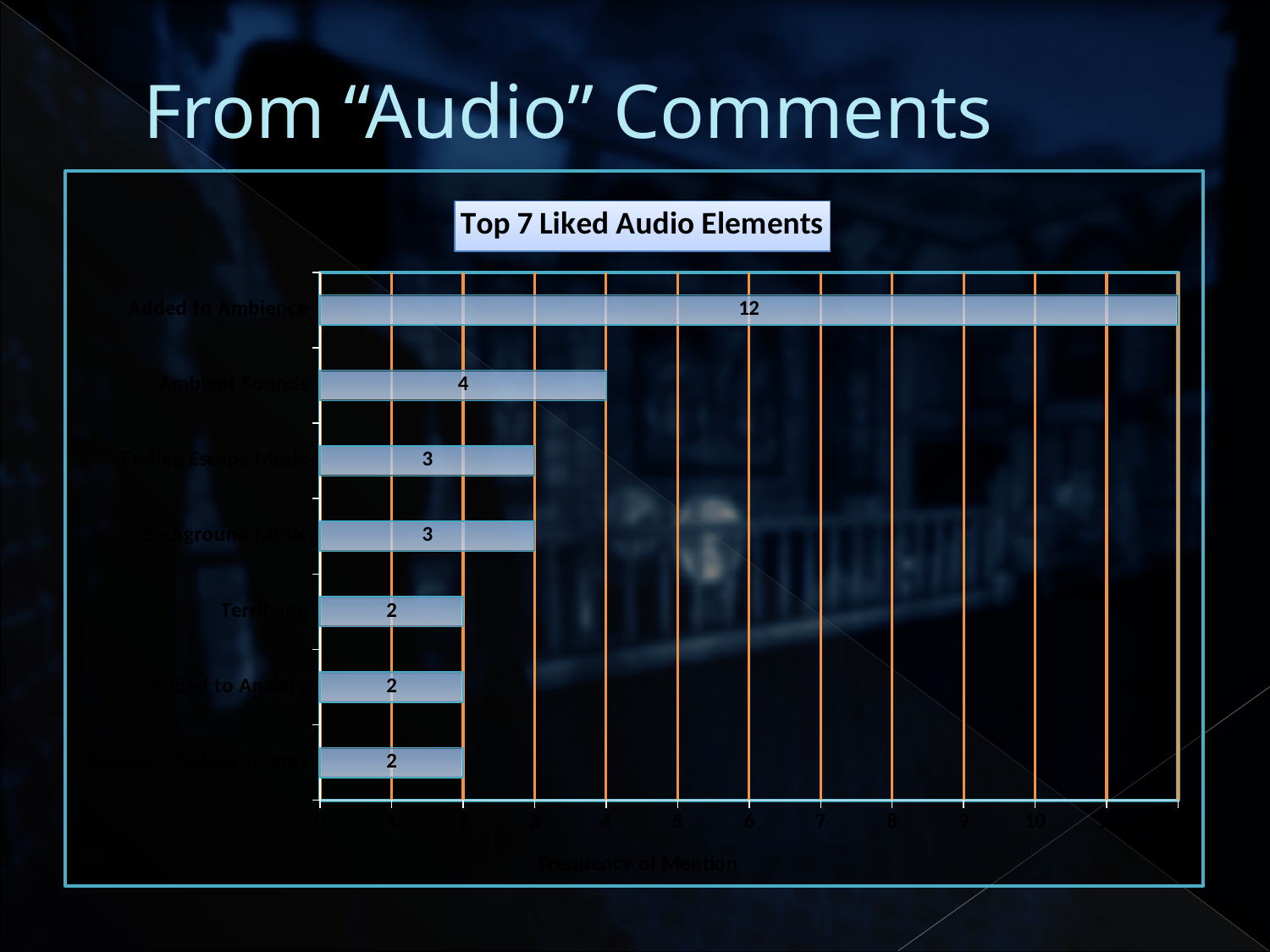
What is the difference between the values for Background Music and Added to Anxiety? 1 What is the title of the chart? Top 7 Liked Audio Elements What is the value for Ending Escape Music? 3 What is the value for Ambient Sounds? 4 How many categories are shown in the chart? 7 What kind of chart is shown on the slide? bar chart What is the value for Added to Ambience? 12 What is the value for Terrifying? 2 What is the difference between the values for Added to Ambience and Ambient Sounds? 8 Which is larger, the value for Ambient Sounds or the value for Background Music? Ambient Sounds Which category has the highest value? Added to Ambience What is the label of the horizontal axis? Frequency of Mention